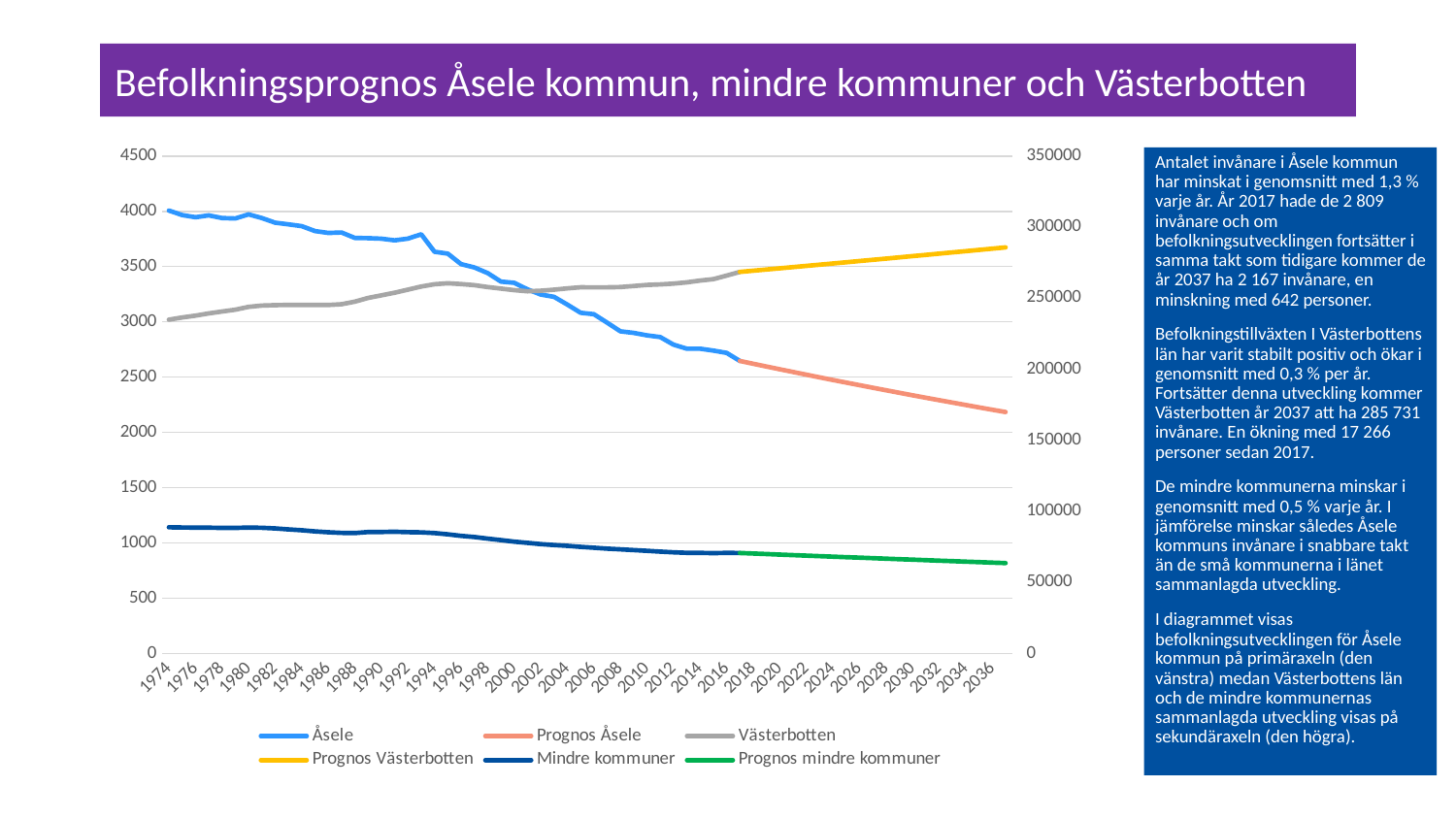
Does the Prognos Åsele line rise or fall from 2018 to 2036? fall What is the last year shown on the x axis? 2036 Which legend entry is drawn in green? Prognos mindre kommuner Is the value for Prognos Åsele in 2036 greater or less than 2500 on the left axis? less How many series does the chart legend list? 6 Does the Åsele line rise or fall from 1974 to 2016? fall What is the title of the chart on the slide? Befolkningsprognos Åsele kommun, mindre kommuner och Västerbotten Does the Västerbotten line rise or fall from 1974 to 2016? rise What kind of chart is shown on the slide? line chart Is the value for Prognos Västerbotten in 2036 greater or less than 250000 on the right axis? greater Is the value for Åsele in 1974 greater or less than 3500 on the left axis? greater Which is larger for Åsele: the value in 1974 or the value in 2016? 1974